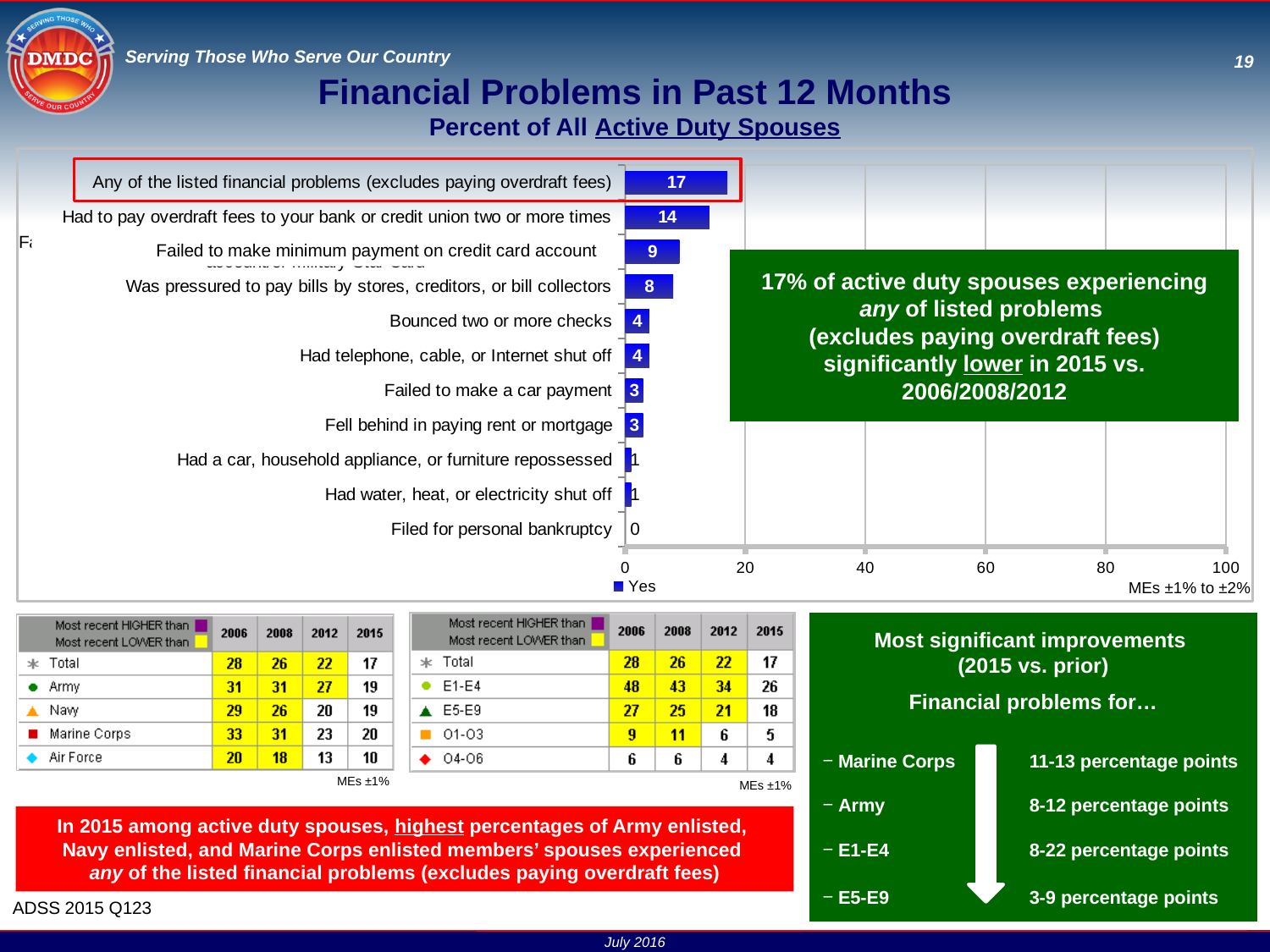
What is the difference between the value for 'Any of the listed financial problems' and the value for 'Had to pay overdraft fees to your bank or credit union two or more times'? 3 Which category has the highest value in the bar chart? Any of the listed financial problems (excludes paying overdraft fees) How many series does the chart legend list? 1 What is the value for 'Failed to make minimum payment on credit card account'? 9 What is the value for 'Filed for personal bankruptcy'? 0 Which category has the lowest value in the bar chart? Filed for personal bankruptcy How many categories are plotted in the bar chart? 11 What kind of chart is shown on the slide? Bar chart What percentage of active duty spouses had to pay overdraft fees to their bank or credit union two or more times? 14 Is the value for 'Any of the listed financial problems (excludes paying overdraft fees)' greater or less than 20? less What is the value for 'Was pressured to pay bills by stores, creditors, or bill collectors'? 8 Which is larger: the value for 'Failed to make minimum payment on credit card account' or the value for 'Bounced two or more checks'? Failed to make minimum payment on credit card account